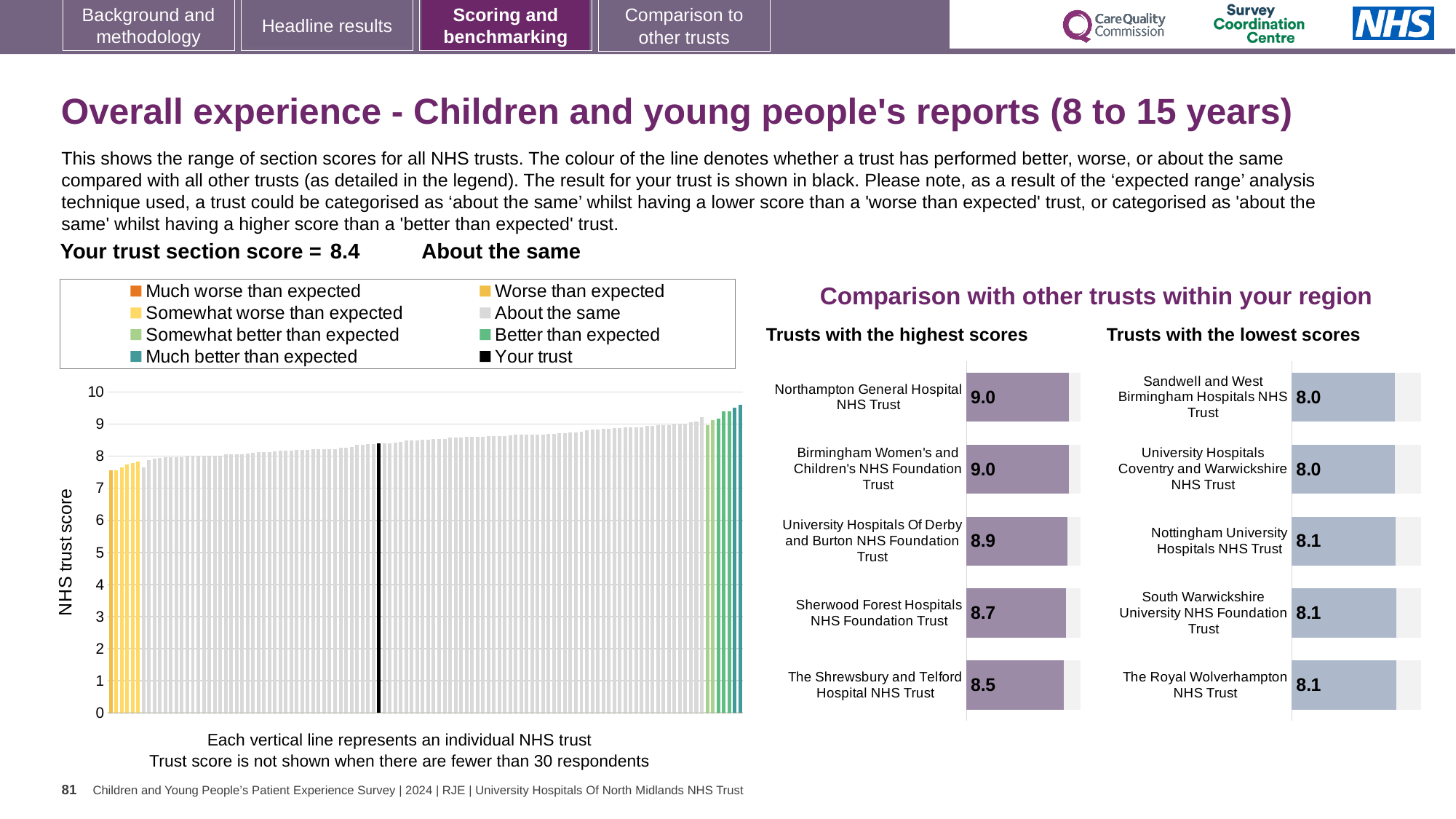
In the 'Trusts with the highest scores' chart, what is the score for Sherwood Forest Hospitals NHS Foundation Trust? 8.7 In the 'NHS trust score' chart, do the bar heights rise or fall from left to right? Rise In the 'Trusts with the highest scores' chart, what is the difference between the score for Northampton General Hospital NHS Trust and The Shrewsbury and Telford Hospital NHS Trust? 0.5 In the 'Trusts with the highest scores' chart, what is the score for Northampton General Hospital NHS Trust? 9.0 What kind of chart is the 'NHS trust score' chart on the left? Bar chart In the 'Trusts with the highest scores' chart, which trust has the lowest score shown? The Shrewsbury and Telford Hospital NHS Trust What is the title of the chart section on the right of the slide? Comparison with other trusts within your region Which is larger: the score for Sherwood Forest Hospitals NHS Foundation Trust in the highest scores chart or the score for The Royal Wolverhampton NHS Trust in the lowest scores chart? Sherwood Forest Hospitals NHS Foundation Trust How many entries does the legend of the 'NHS trust score' chart list? 8 In the 'Trusts with the lowest scores' chart, what is the score for Nottingham University Hospitals NHS Trust? 8.1 In the 'NHS trust score' chart, is the value of the black bar (your trust) greater or less than 8? greater How many trusts are listed in the 'Trusts with the lowest scores' chart? 5